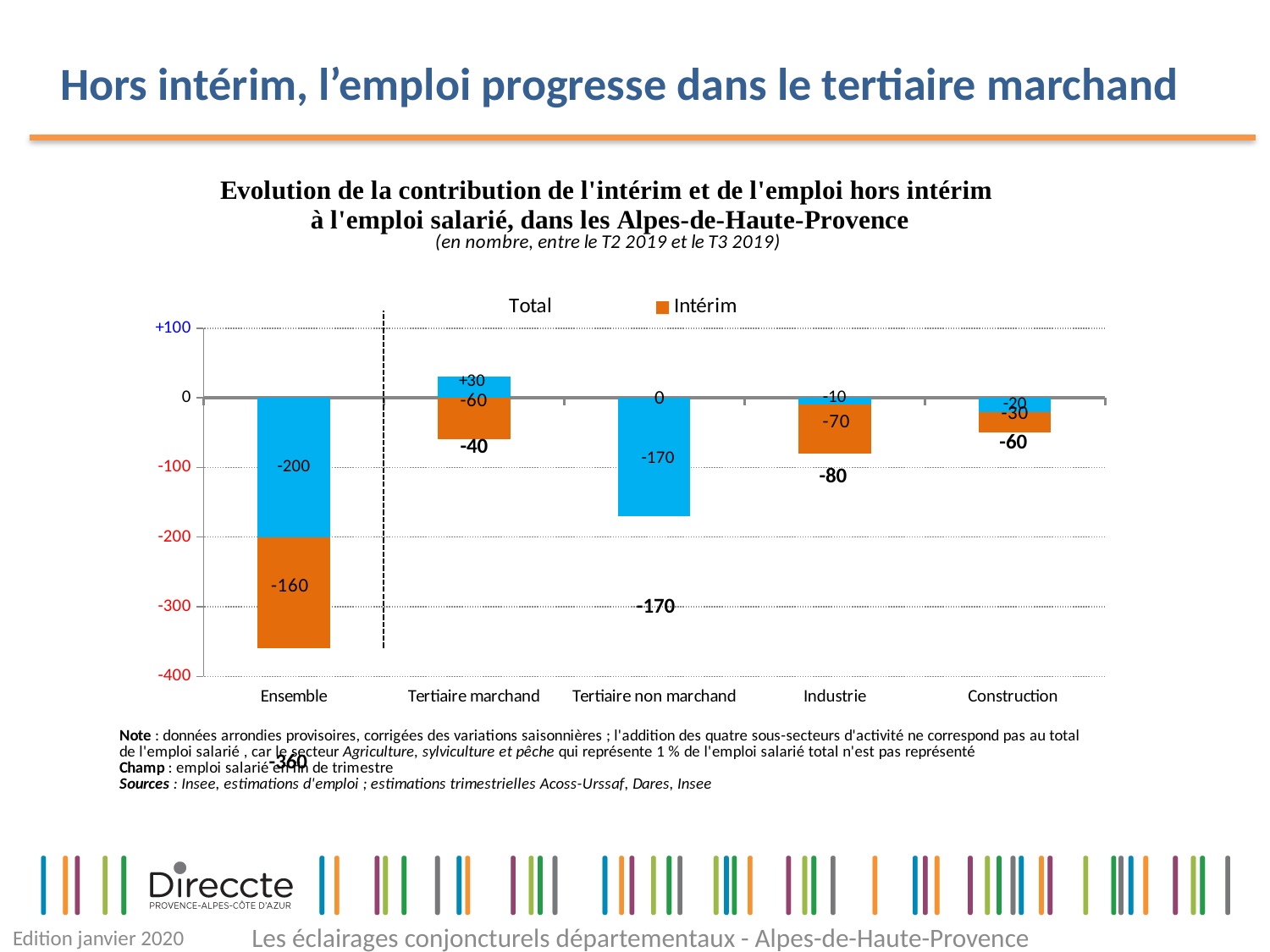
What type of chart is this? Bar chart What is the Intérim value for Ensemble? -160 What is the Total value shown for Industrie? -80 What is the value of the blue bar for Tertiaire marchand? +30 What is the Total value shown for Construction? -60 What is the Total value shown for Ensemble? -360 Which is larger, the Intérim value for Tertiaire marchand or for Industrie? Tertiaire marchand What is the Intérim value for Industrie? -70 What is the Intérim value for Tertiaire non marchand? 0 How many categories are shown on the x axis? 5 What is the difference between the Intérim values for Industrie and Construction? 40 Which category has the lowest Intérim value? Ensemble